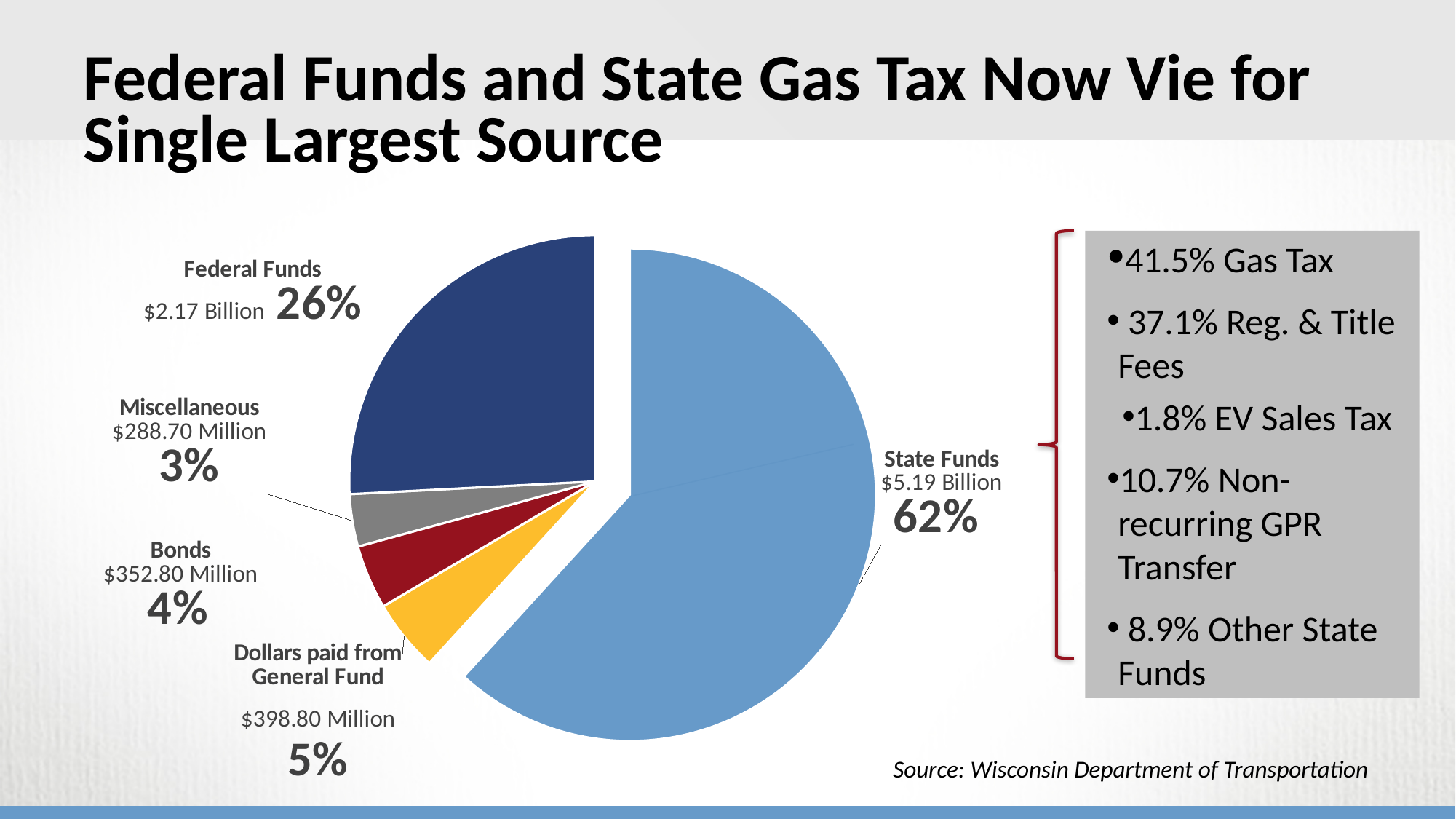
What share of the pie is Federal Funds? 26% How many slices does the pie chart have? 5 What is the difference in percentage points between the State Funds share and the Federal Funds share? 36 percentage points What is the dollar value shown for Bonds? $352.80 Million Which is larger, the Bonds slice or the Dollars paid from General Fund slice? Dollars paid from General Fund What is the dollar value shown for Miscellaneous? $288.70 Million What kind of chart is shown on the slide? Pie chart Which slice of the pie is the largest? State Funds What share of the pie is State Funds? 62% What is the dollar value shown for Federal Funds? $2.17 Billion What is the dollar value shown for State Funds? $5.19 Billion Which slice of the pie is the smallest? Miscellaneous